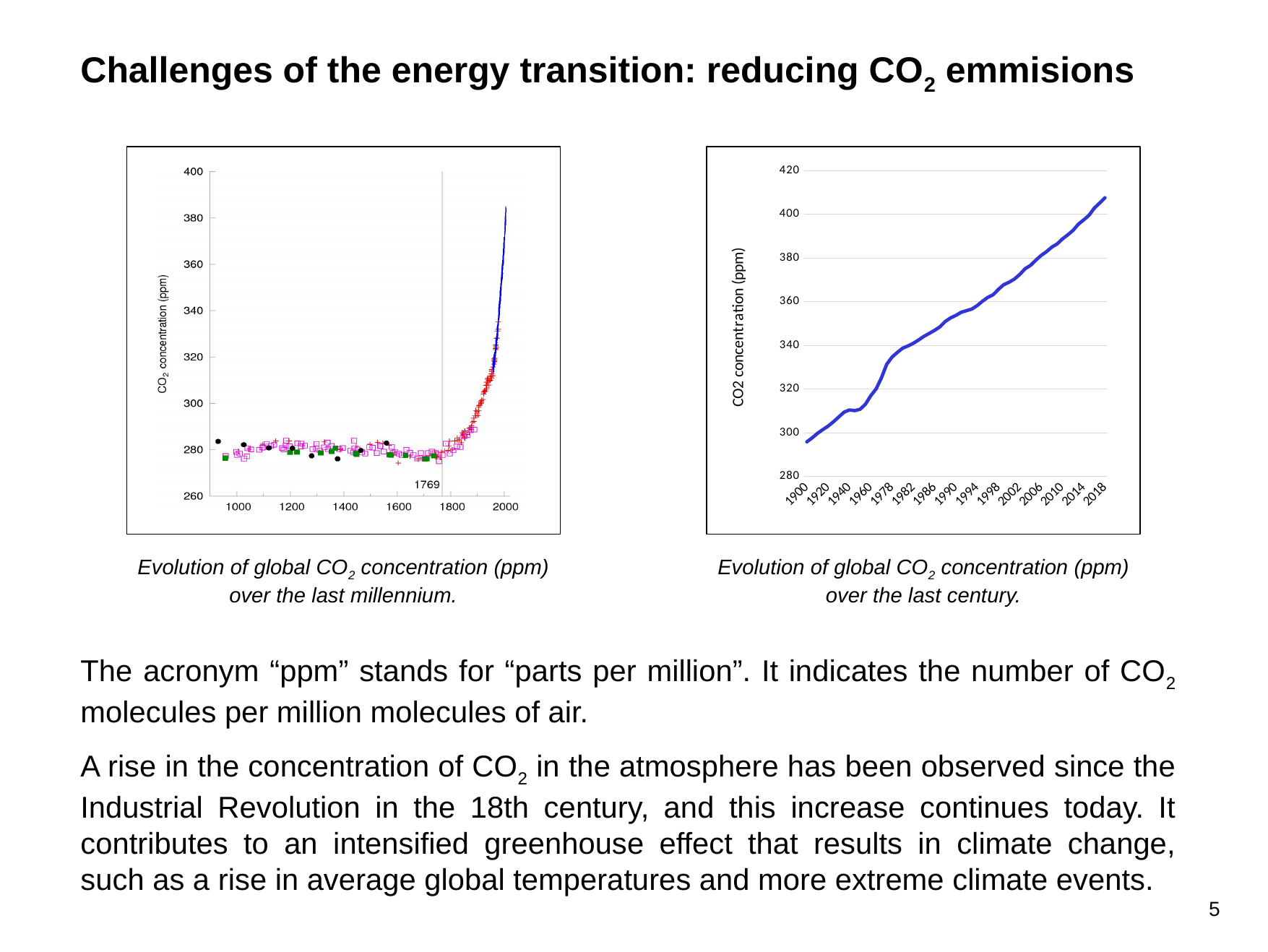
What year is marked by the vertical line in the chart on the left (over the last millennium)? 1769 In the chart on the left (over the last millennium), which of the two is larger: the value around the year 1200 or the value around the year 2000? the value around the year 2000 In the chart on the left (over the last millennium), is the value around the year 1000 greater or less than 300? less In the chart on the right (over the last century), is the value for 1940 greater or less than 320? less What is the y-axis label of the chart on the right (over the last century)? CO2 concentration (ppm) In the chart on the right (over the last century), is the value for 2002 greater or less than 360? greater What kind of chart is the chart on the right (over the last century)? line chart In the chart on the right (over the last century), do the values rise or fall from 1900 to 2018? rise